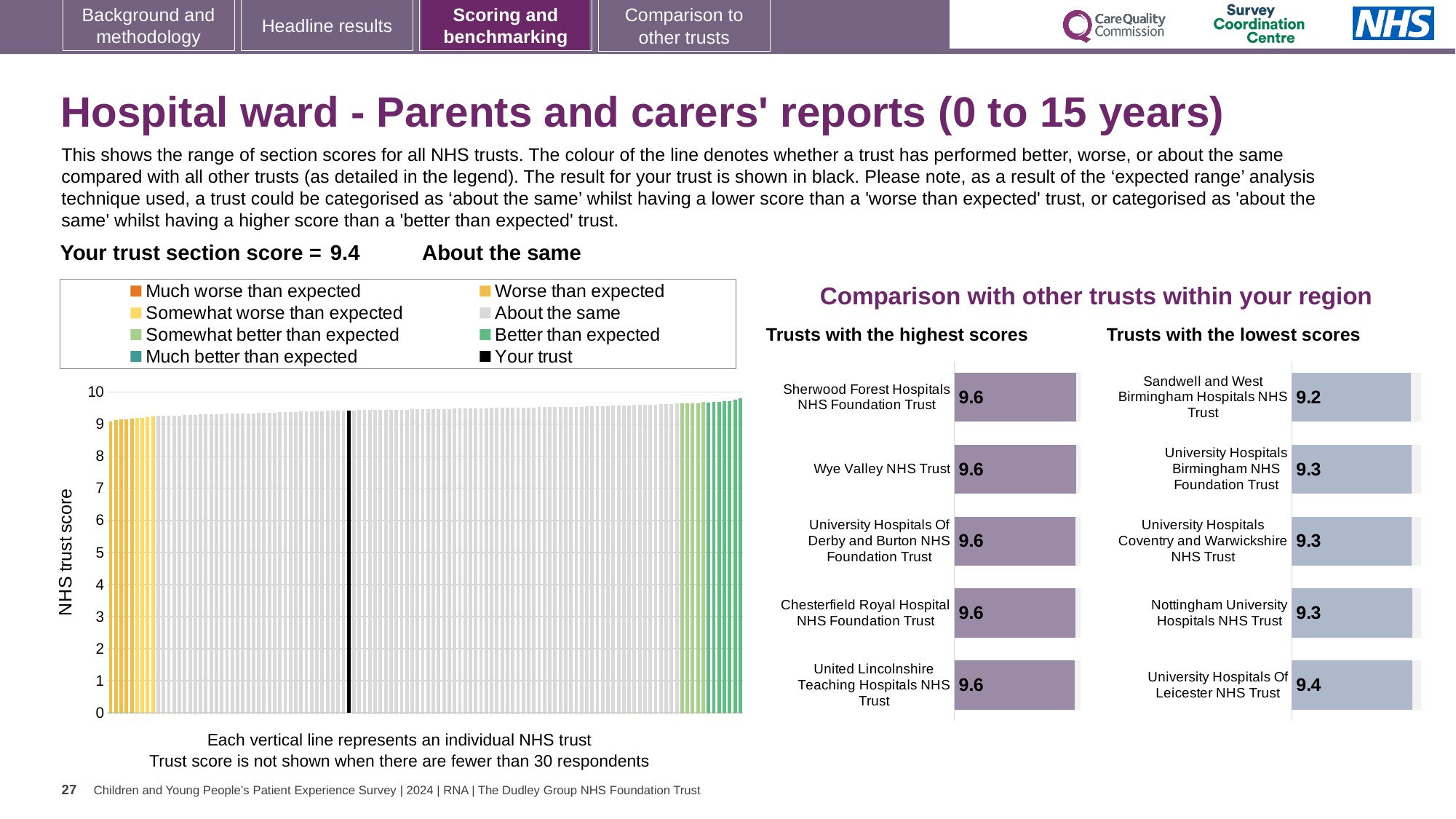
How many trusts are shown in the 'Trusts with the highest scores' chart? 5 In the large chart on the left, do the trust scores rise or fall from left to right along the x axis? Rise What kind of chart is the large chart on the left showing NHS trust scores? Bar chart How many entries does the legend above the large chart on the left list? 8 In the 'Trusts with the lowest scores' chart, which trust has the highest score? University Hospitals Of Leicester NHS Trust In the large chart on the left, is the value for the black bar (your trust) greater or less than 8? greater In the large chart on the left, what is the label on the vertical axis? NHS trust score In the 'Trusts with the lowest scores' chart, what is the score for Sandwell and West Birmingham Hospitals NHS Trust? 9.2 In the 'Trusts with the lowest scores' chart, which trust has the lowest score? Sandwell and West Birmingham Hospitals NHS Trust In the 'Trusts with the highest scores' chart, what is the score for Wye Valley NHS Trust? 9.6 In the 'Trusts with the lowest scores' chart, what is the difference between the scores of University Hospitals Of Leicester NHS Trust and Sandwell and West Birmingham Hospitals NHS Trust? 0.2 In the 'Trusts with the lowest scores' chart, which has the larger score: Nottingham University Hospitals NHS Trust or Sandwell and West Birmingham Hospitals NHS Trust? Nottingham University Hospitals NHS Trust